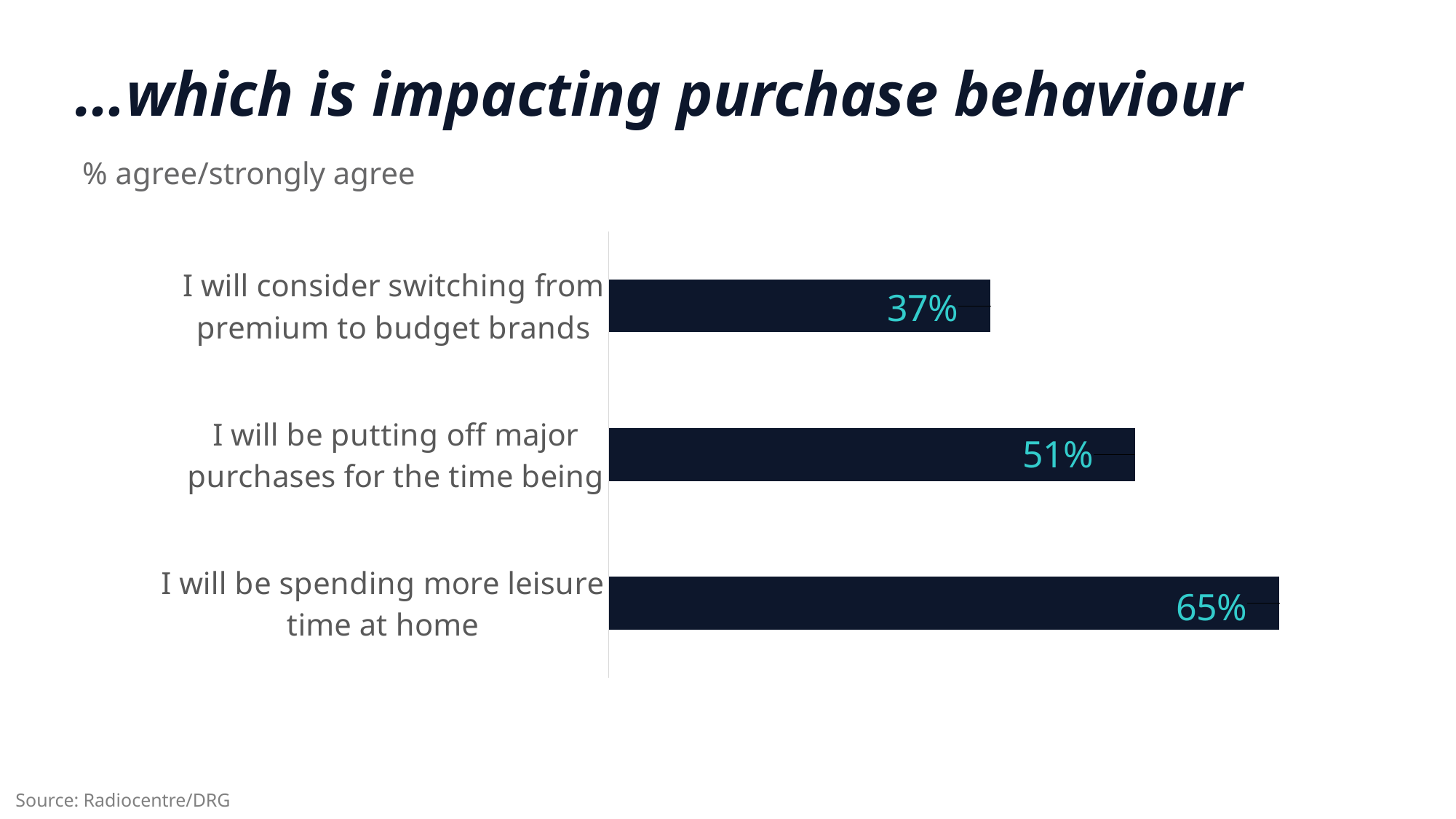
What percentage agree or strongly agree that they will be putting off major purchases for the time being? 51% What type of chart is shown on the slide? Bar chart Which statement has the highest percentage of agreement? I will be spending more leisure time at home Which has a higher percentage: 'I will be putting off major purchases for the time being' or 'I will consider switching from premium to budget brands'? I will be putting off major purchases for the time being Which statement has the lowest percentage of agreement? I will consider switching from premium to budget brands How many statements are shown in the chart? 3 What is the difference in percentage points between 'I will be putting off major purchases for the time being' and 'I will consider switching from premium to budget brands'? 14 What measure do the bars represent, according to the chart subtitle? % agree/strongly agree What percentage agree or strongly agree that they will consider switching from premium to budget brands? 37% What percentage agree or strongly agree that they will be spending more leisure time at home? 65% What is the difference in percentage points between 'I will be spending more leisure time at home' and 'I will consider switching from premium to budget brands'? 28 What is the title of the slide? ...which is impacting purchase behaviour